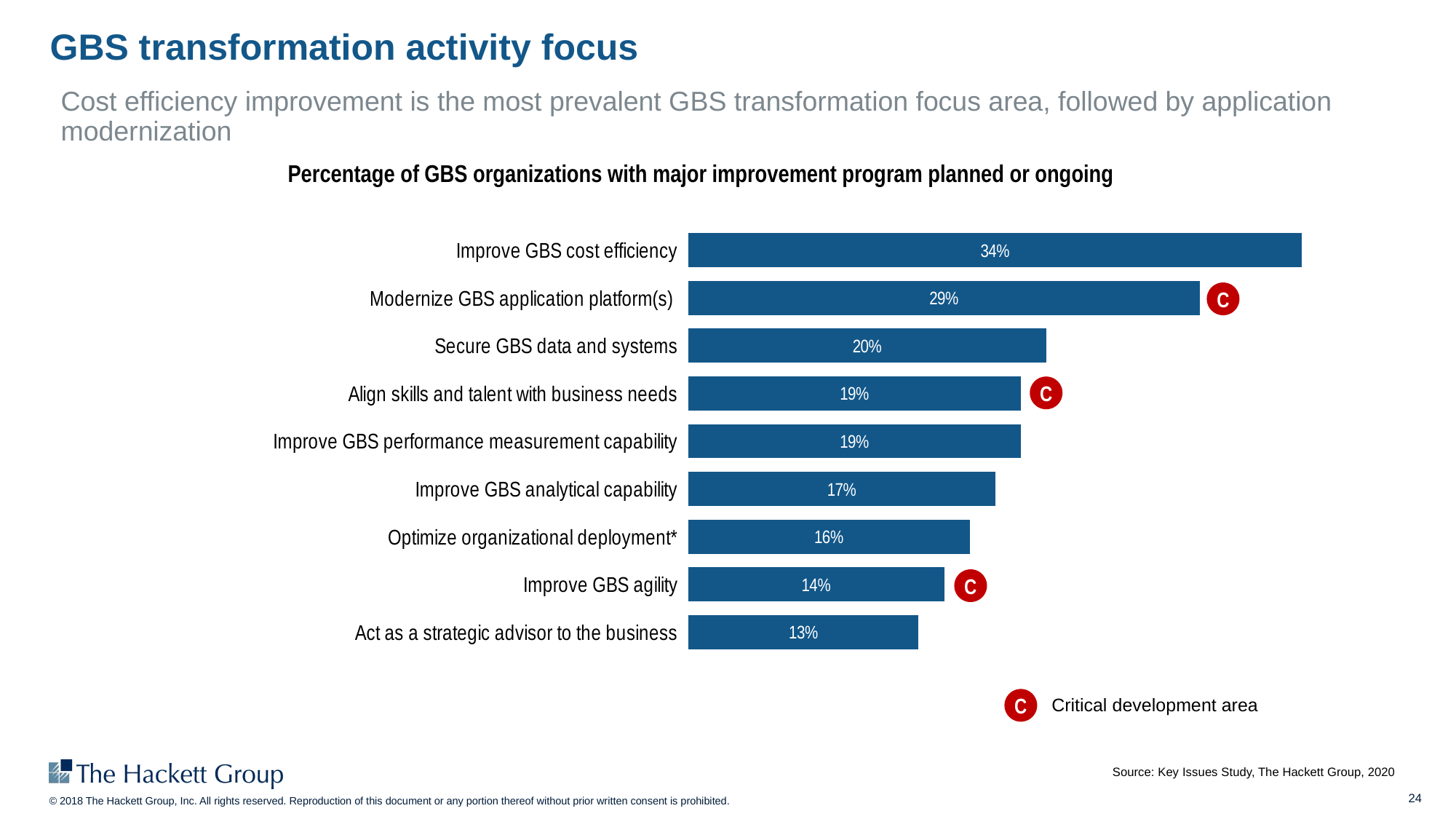
What is the value shown for 'Improve GBS agility'? 14% What is the title of the chart? Percentage of GBS organizations with major improvement program planned or ongoing What is the difference in percentage points between 'Secure GBS data and systems' and 'Act as a strategic advisor to the business'? 7 percentage points Which category has the highest percentage in the chart? Improve GBS cost efficiency What is the value shown for 'Secure GBS data and systems'? 20% How many categories are shown in the bar chart? 9 Which category has the lowest percentage in the chart? Act as a strategic advisor to the business How many categories are marked with the red 'C' symbol for critical development area? 3 What percentage of GBS organizations have a major improvement program planned or ongoing for 'Improve GBS cost efficiency'? 34% What type of chart is shown on the slide? Bar chart What is the difference in percentage points between 'Improve GBS cost efficiency' and 'Modernize GBS application platform(s)'? 5 percentage points Which is larger: the value for 'Improve GBS analytical capability' or the value for 'Optimize organizational deployment*'? Improve GBS analytical capability